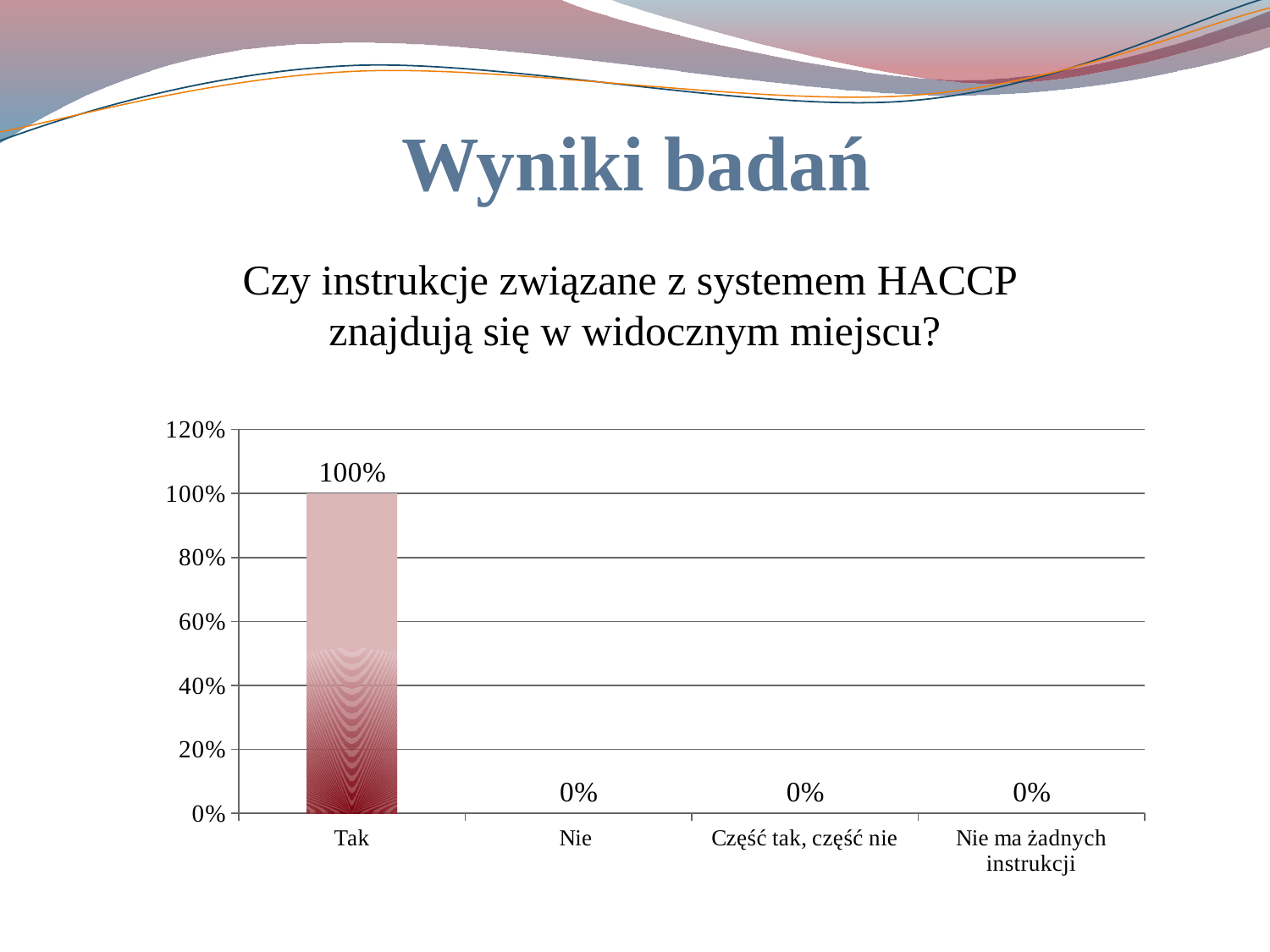
What is the value for "Część tak, część nie"? 0% What is the value for "Nie ma żadnych instrukcji"? 0% What kind of chart is shown on the slide? bar chart Is the value for "Tak" greater or less than 80%? greater How many categories are shown on the x axis? 4 What is the value for "Tak"? 100% Which is larger, the value for "Tak" or the value for "Część tak, część nie"? Tak What is the highest value shown on the y axis? 120% What is the difference between the values for "Tak" and "Nie"? 100% What question does the chart's title ask? Czy instrukcje związane z systemem HACCP znajdują się w widocznym miejscu? What is the value for "Nie"? 0% Which category has the highest value? Tak